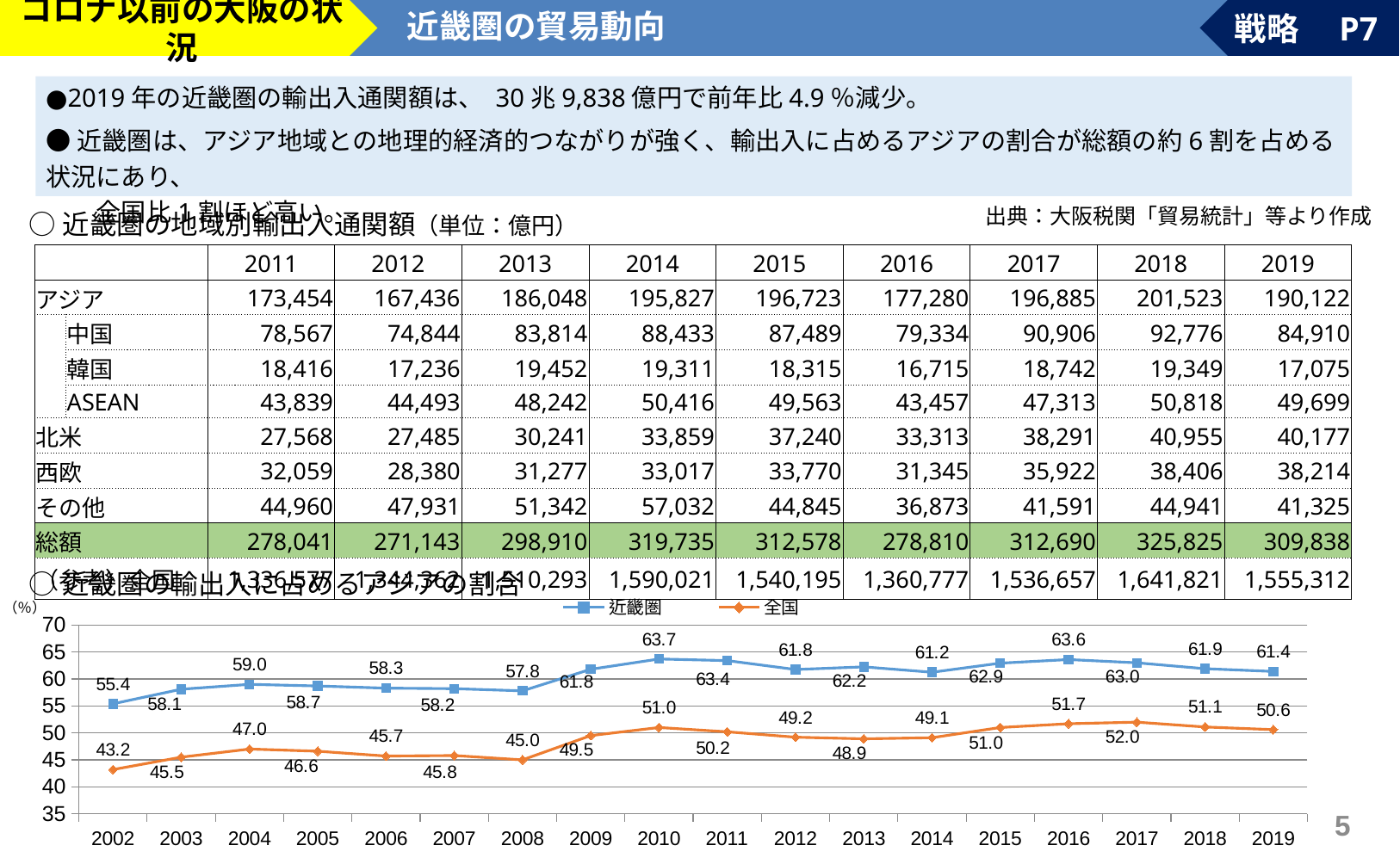
In the line chart, how many series does the legend list? 2 In the line chart, which series has the larger value in 2008, 近畿圏 or 全国? 近畿圏 In the line chart, what is the value for 全国 in 2017? 52.0 In the line chart, how many years are plotted along the x axis? 18 In the line chart, what is the difference between the 近畿圏 and 全国 values in 2019? 10.8 What type of chart is shown at the bottom of the slide (近畿圏の輸出入に占めるアジアの割合)? line chart In the line chart, in which year is the 全国 value lowest? 2002 In the line chart, does the 近畿圏 value rise or fall from 2008 to 2010? rise In the line chart, in which year is the 全国 value highest? 2017 In the line chart, what is the value for 近畿圏 in 2019? 61.4 In the line chart, which colour is used for the 全国 series? orange In the line chart, what is the value for 近畿圏 in 2010? 63.7